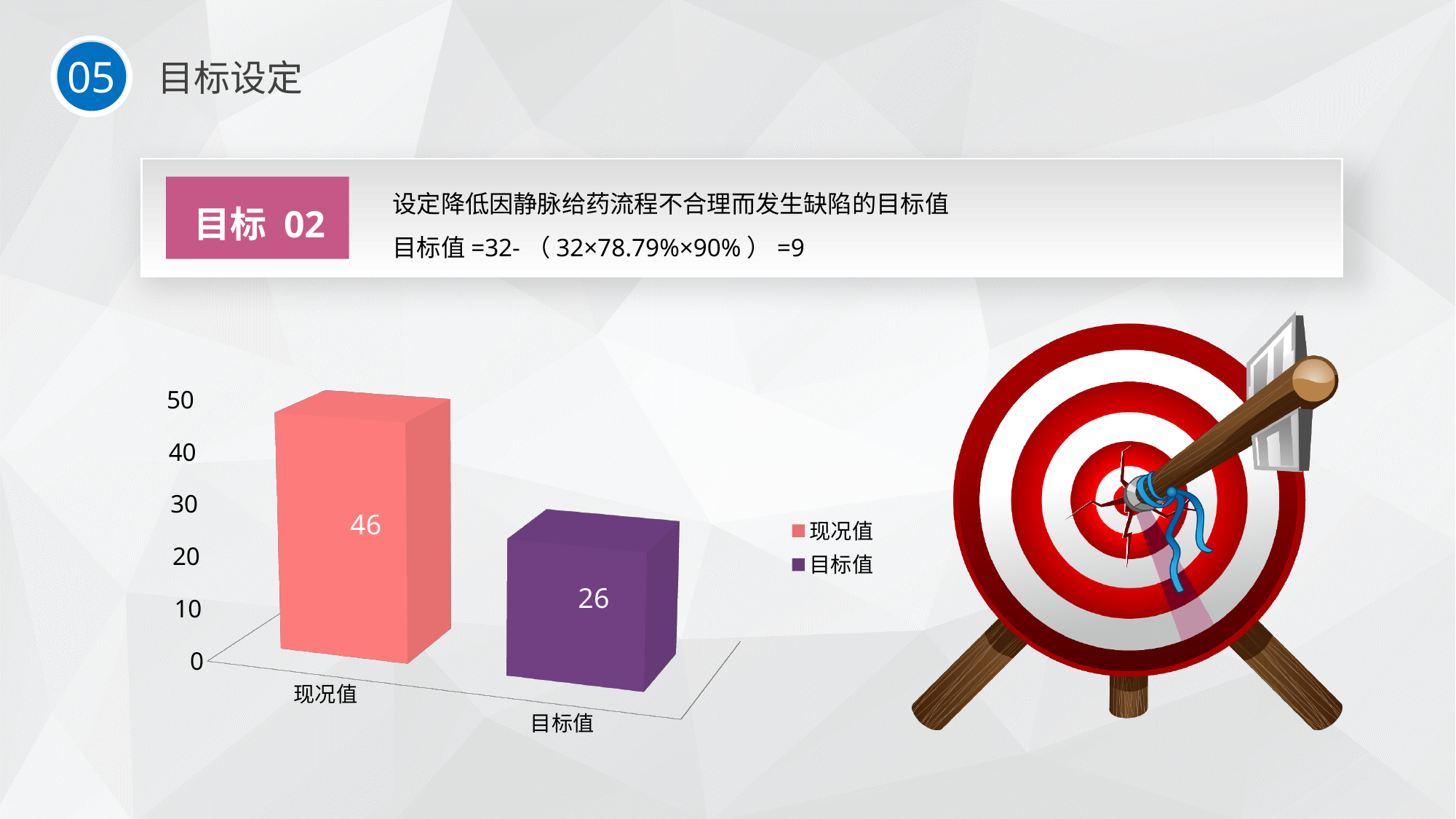
What is the difference between the 现况值 and 目标值 values? 20 How many bars are plotted in the chart? 2 Is the value for 现况值 greater or less than 40? greater How many entries does the legend list? 2 What colour is the 目标值 bar? purple What kind of chart is shown on the slide? bar chart What is the value for 目标值 in the chart? 26 Which category has the lowest value in the chart? 目标值 Which is larger, 现况值 or 目标值? 现况值 What is the value for 现况值 in the chart? 46 Which category has the highest value in the chart? 现况值 Is the value for 目标值 greater or less than 30? less